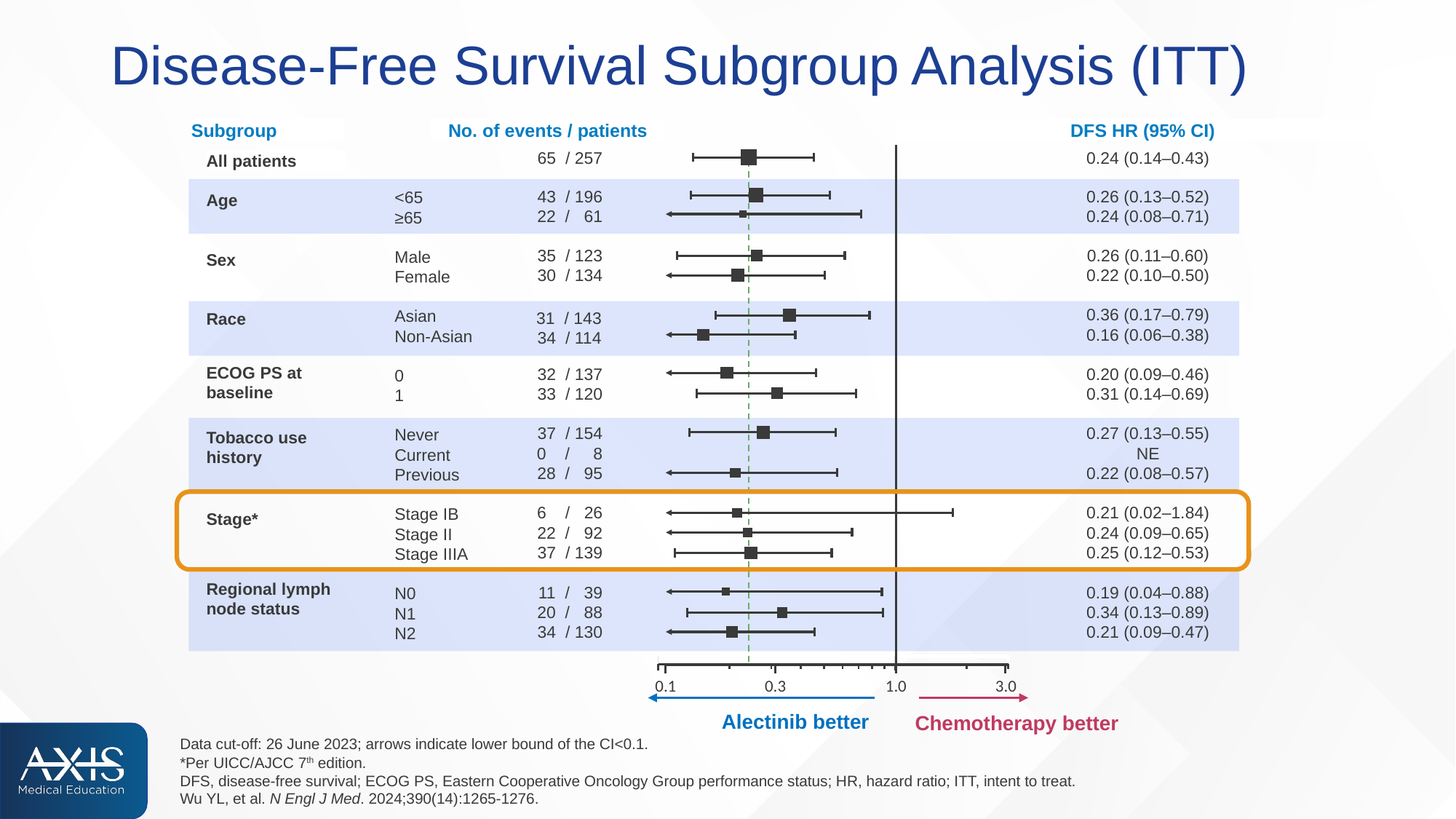
What is the difference between the DFS hazard ratios for the Asian and Non-Asian subgroups? 0.20 What is the total number of patients across the two Age subgroups (<65 and ≥65)? 257 What is the number of events / patients for Stage IIIA? 37 / 139 How many Stage subgroups are plotted? 3 Which has the larger DFS hazard ratio, ECOG PS 0 or ECOG PS 1? ECOG PS 1 Which subgroup row is highlighted with an orange box? Stage* Which subgroup has the highest DFS hazard ratio point estimate? Asian (0.36) What is the DFS HR (95% CI) for the Non-Asian subgroup? 0.16 (0.06–0.38) What is the DFS HR (95% CI) for All patients? 0.24 (0.14–0.43) What type of chart is shown on the slide? Forest plot Which subgroup has the lowest DFS hazard ratio point estimate? Non-Asian (0.16) Is the DFS hazard ratio for All patients greater or less than 1.0? less